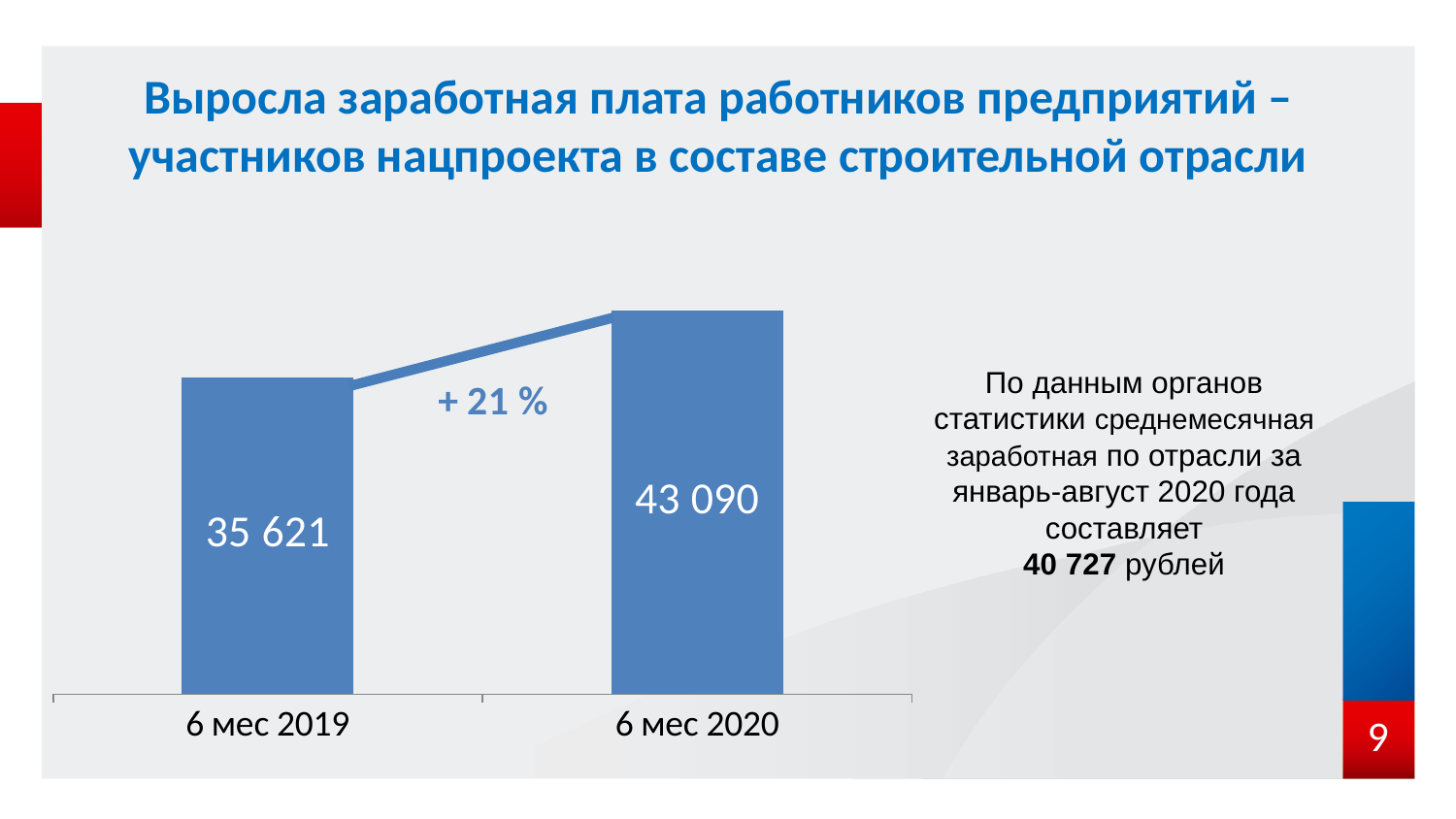
Do the values rise or fall from 6 мес 2019 to 6 мес 2020? rise Which category has the lowest value? 6 мес 2019 How many categories are shown on the x axis of the chart? 2 What percentage change is annotated between the two bars on the chart? + 21 % What is the value for 6 мес 2019? 35 621 Which category has the highest value? 6 мес 2020 What is the value for 6 мес 2020? 43 090 What kind of chart is shown on the slide? bar chart What colour are the bars in the chart? blue Which is larger, the value for 6 мес 2019 or the value for 6 мес 2020? 6 мес 2020 What is the difference between the values for 6 мес 2020 and 6 мес 2019? 7 469